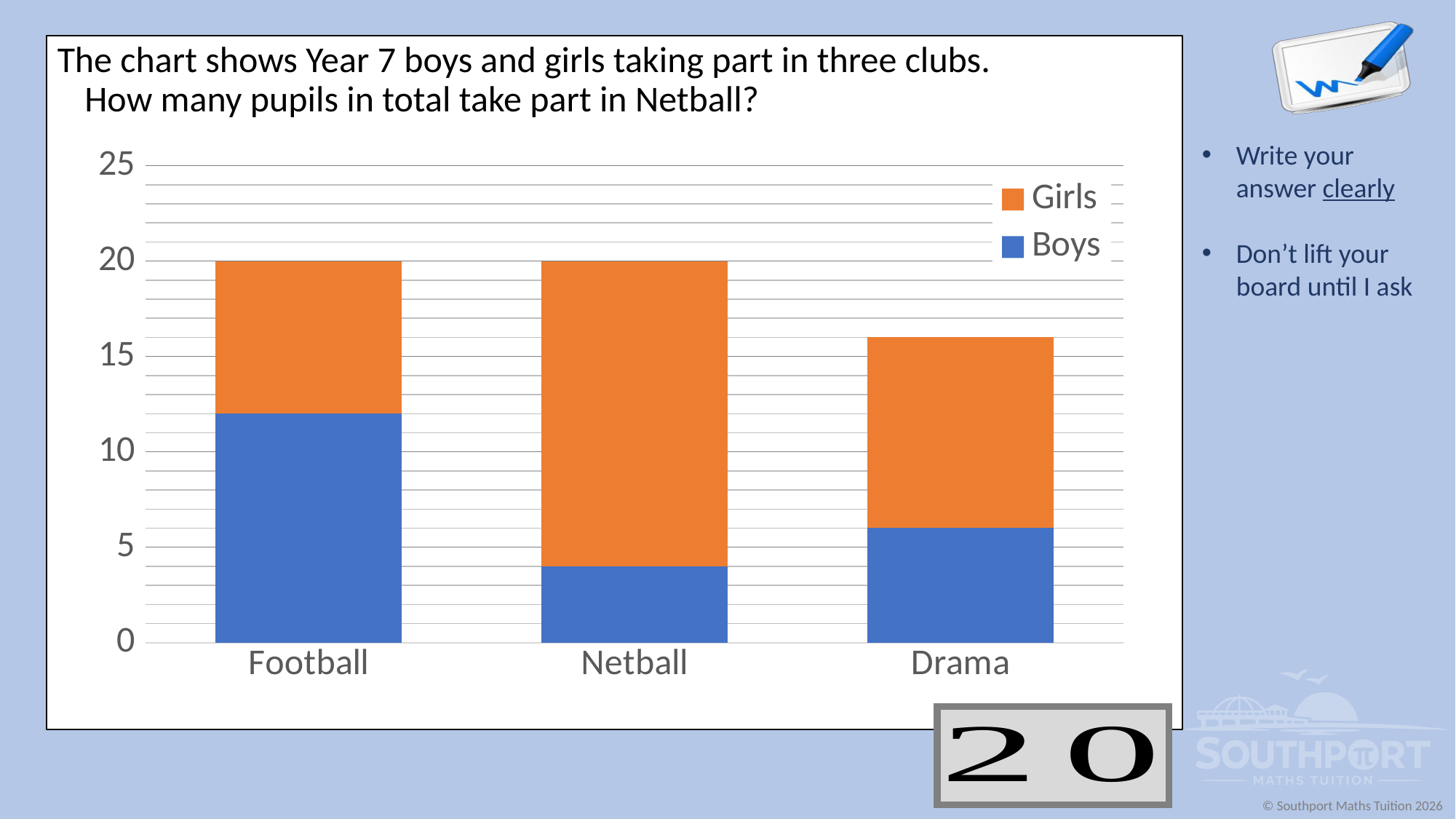
Which colour represents Girls in the chart? Orange What is the total number of pupils taking part in Football? 20 How many series does the chart's legend list? 2 Is the number of boys taking part in Netball greater or less than 5? less Is the total number of pupils taking part in Drama greater or less than 15? greater What kind of chart is shown on the slide? Stacked bar chart Which club has more girls taking part, Netball or Drama? Netball What is the total number of pupils taking part in Netball? 20 How many clubs are shown on the x axis of the chart? 3 Which club has more boys taking part, Football or Netball? Football Which club has the lowest total number of pupils? Drama Is the number of boys taking part in Football greater or less than 10? greater